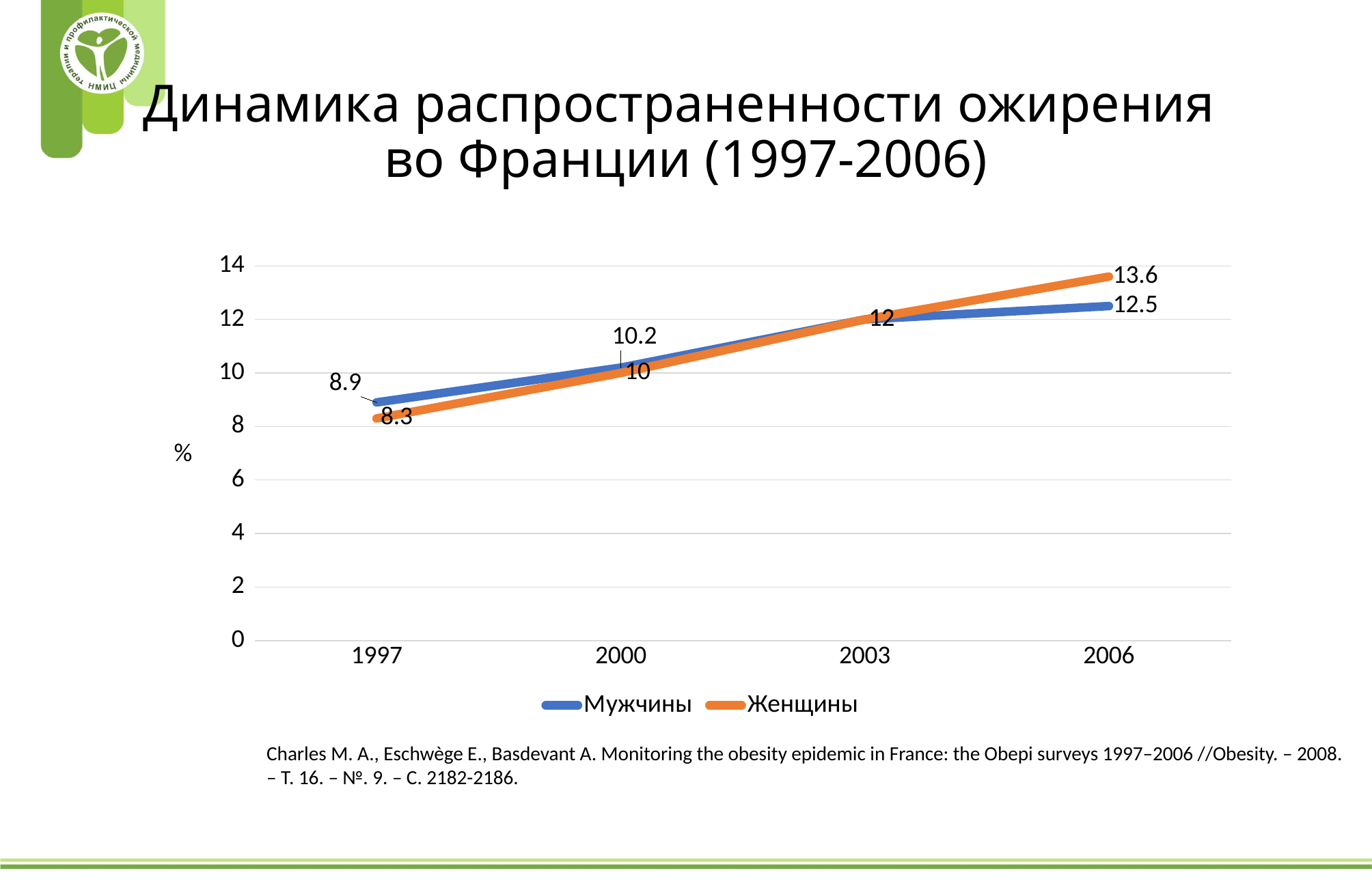
What kind of chart is shown on the slide? line chart What is the value for Женщины in 1997? 8.3 Do the values for Мужчины rise or fall from 1997 to 2006? rise What is the value for Мужчины in 1997? 8.9 What is the value for Женщины in 2006? 13.6 What is the value for Мужчины in 2006? 12.5 By how much did the value for Женщины increase from 1997 to 2006? 5.3 How many series does the legend list? 2 In 2006, which series has the higher value, Мужчины or Женщины? Женщины How many years are plotted along the x axis? 4 What is the value for Женщины in 2000? 10 What is the value for Мужчины in 2000? 10.2